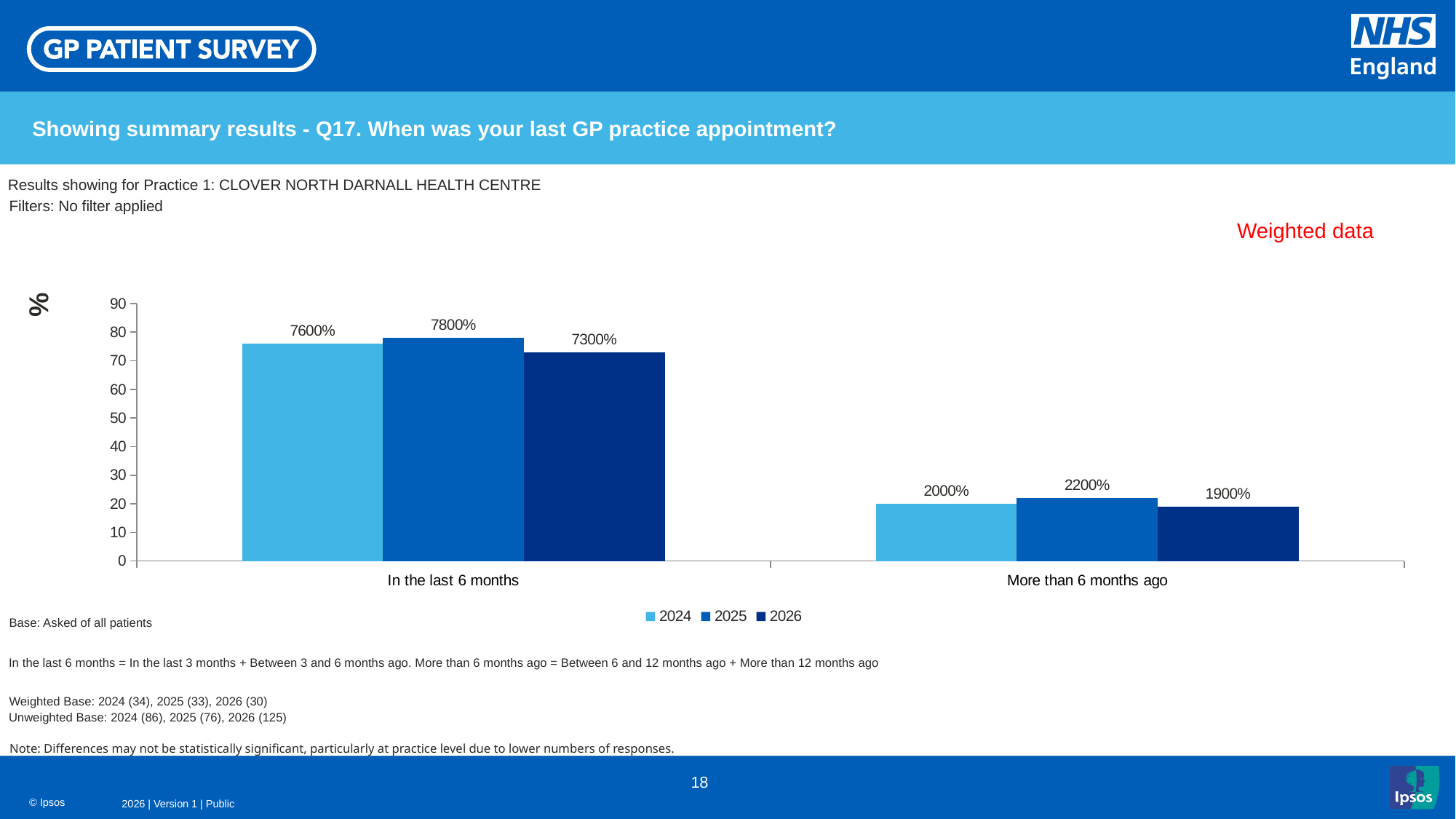
Is the 2026 bar for 'In the last 6 months' greater or less than 70 on the axis? greater How many series does the legend list? 3 What is the data label for 2024 in the 'In the last 6 months' category? 7600% How many categories are shown on the x axis? 2 What is the data label for 2024 in the 'More than 6 months ago' category? 2000% What is the data label for 2025 in the 'In the last 6 months' category? 7800% Which year has the lowest bar in the 'More than 6 months ago' category? 2026 In the 'More than 6 months ago' category, is the 2025 bar larger or smaller than the 2024 bar? larger Which year has the highest bar in the 'In the last 6 months' category? 2025 What is the data label for 2026 in the 'More than 6 months ago' category? 1900% What is the data label for 2026 in the 'In the last 6 months' category? 7300% What kind of chart is shown on the slide? bar chart